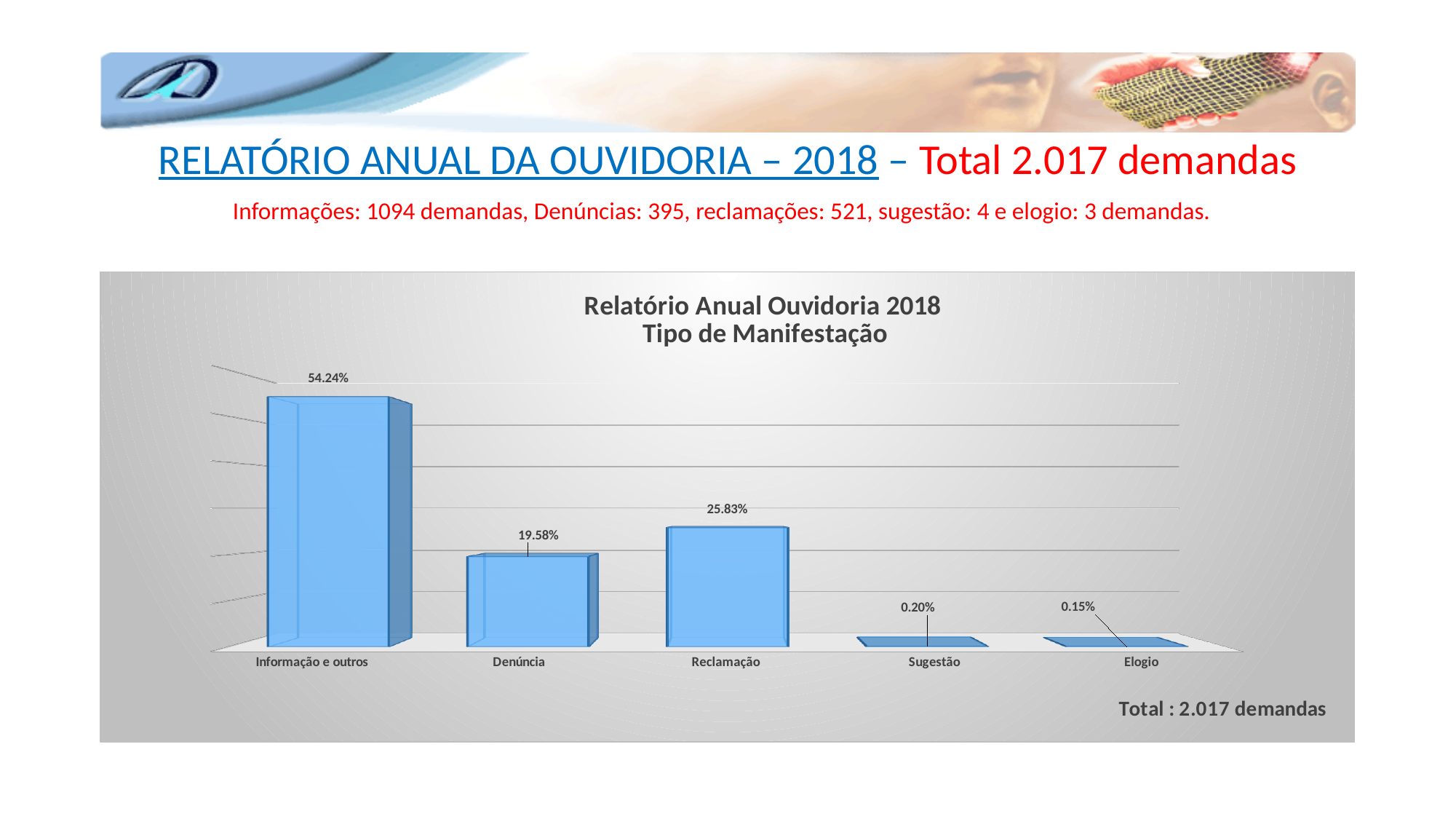
What is the title of the chart? Relatório Anual Ouvidoria 2018 Tipo de Manifestação Which is larger, the value for Denúncia or the value for Reclamação? Reclamação What is the difference between the values for Informação e outros and Reclamação? 28.41% What is the value for Denúncia? 19.58% Which category has the lowest value? Elogio What is the value for Sugestão? 0.20% What kind of chart is shown on the slide? Bar chart What is the value for Elogio? 0.15% What is the value for Reclamação? 25.83% Which category has the highest value? Informação e outros What is the value for Informação e outros? 54.24% How many categories are shown on the x axis? 5